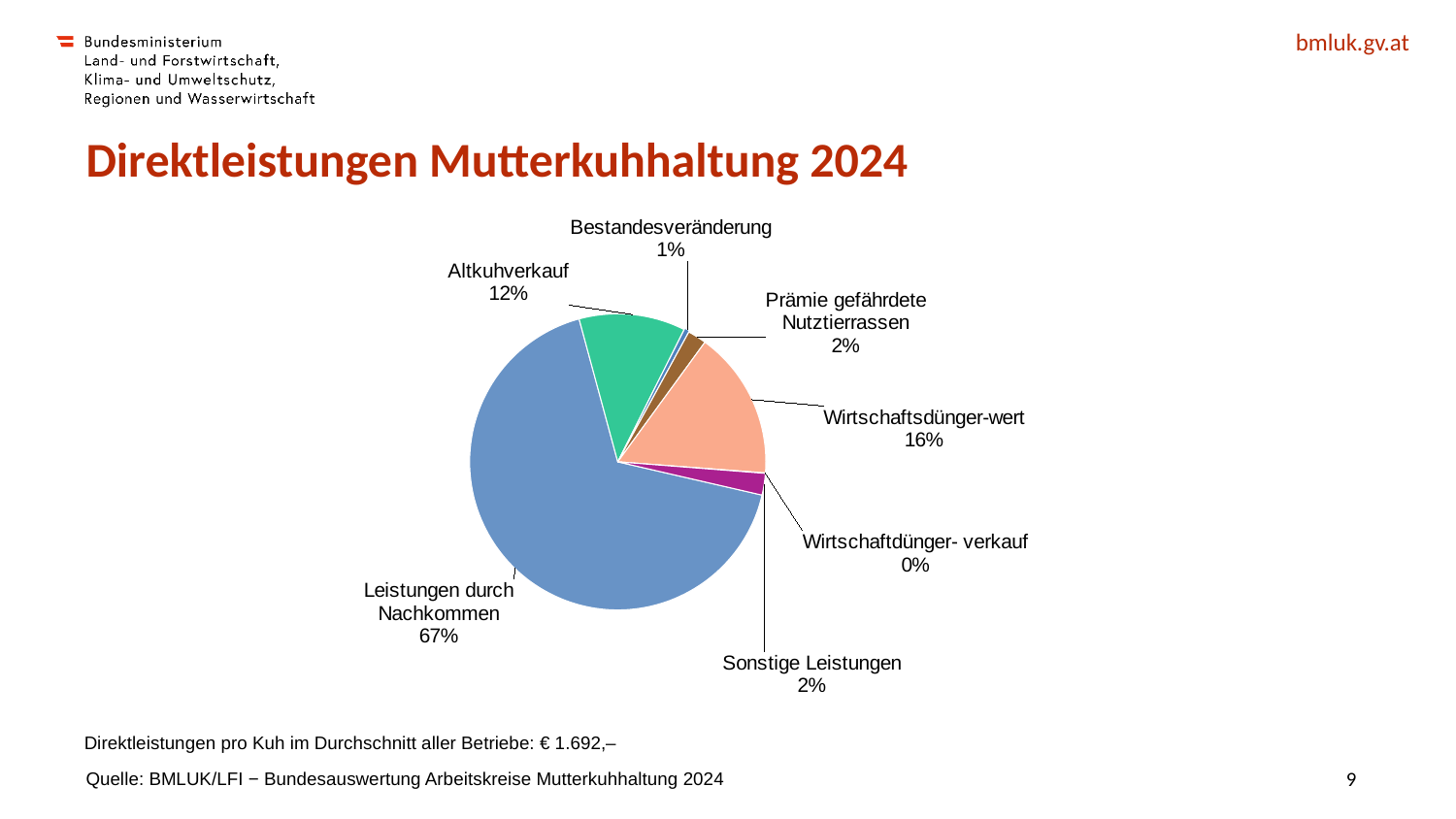
Which is larger, the share for Altkuhverkauf or the share for Wirtschaftsdünger-wert? Wirtschaftsdünger-wert How many slices does the pie chart have? 7 Which category has the smallest share of the pie? Wirtschaftdünger- verkauf What kind of chart is shown on the slide? pie chart What is the value shown for Altkuhverkauf? 12% What share of the pie does Leistungen durch Nachkommen have? 67% What is the value shown for Wirtschaftsdünger-wert? 16% What is the difference in percentage points between Wirtschaftsdünger-wert and Altkuhverkauf? 4 What is the value shown for Wirtschaftdünger- verkauf? 0% What is the title of the chart on the slide? Direktleistungen Mutterkuhhaltung 2024 What is the value shown for Bestandesveränderung? 1% Which category has the largest share of the pie? Leistungen durch Nachkommen